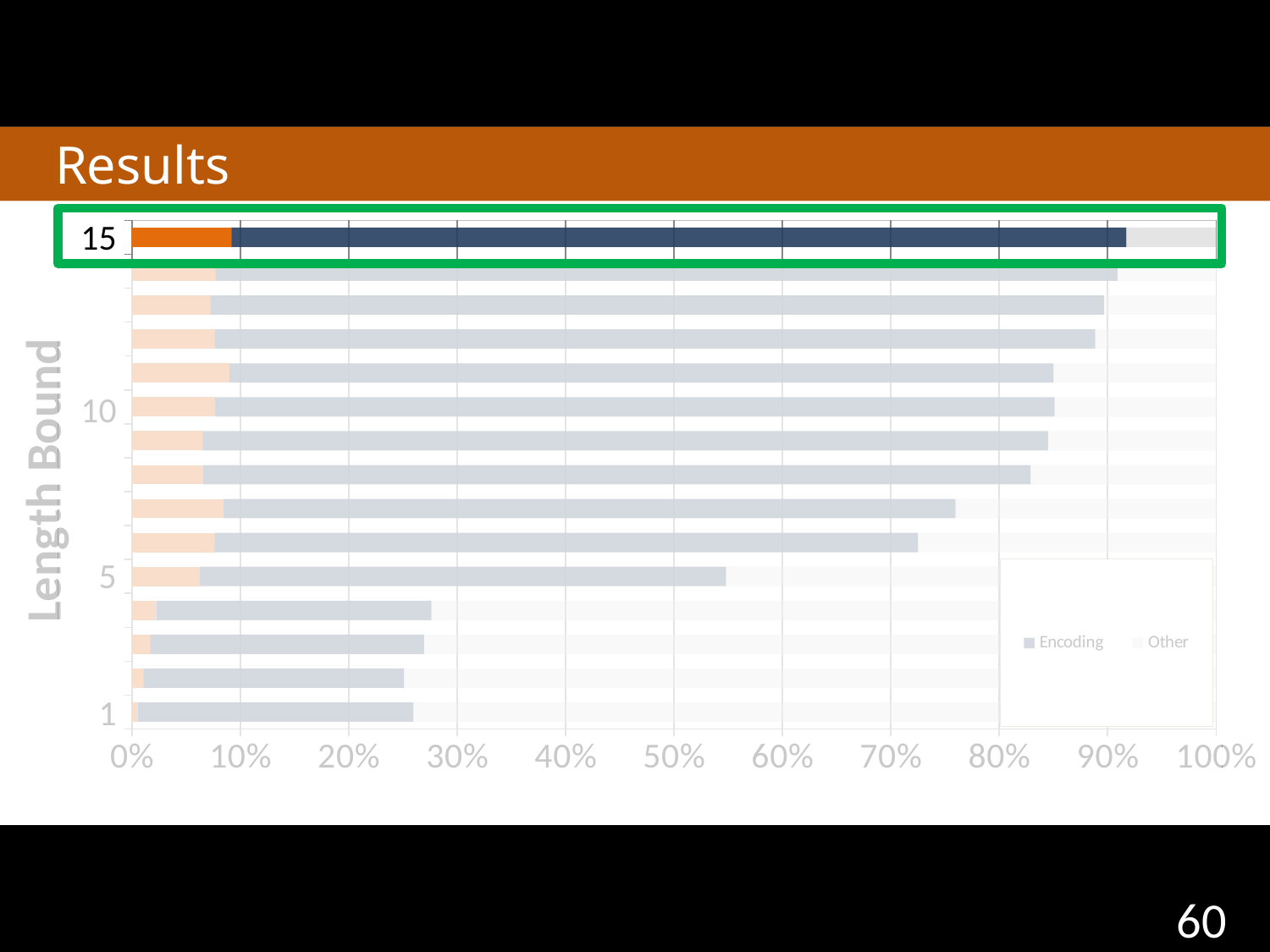
Is the total bar for length bound 10 greater or less than 80%? greater Is the total bar for length bound 5 greater or less than 50%? greater Is the total bar for length bound 15 greater or less than 90%? greater How many bars (length bound categories) does the chart show? 15 What kind of chart is shown on the slide? bar chart What is the title of the vertical axis? Length Bound Which length bound's bar is highlighted with a green box? 15